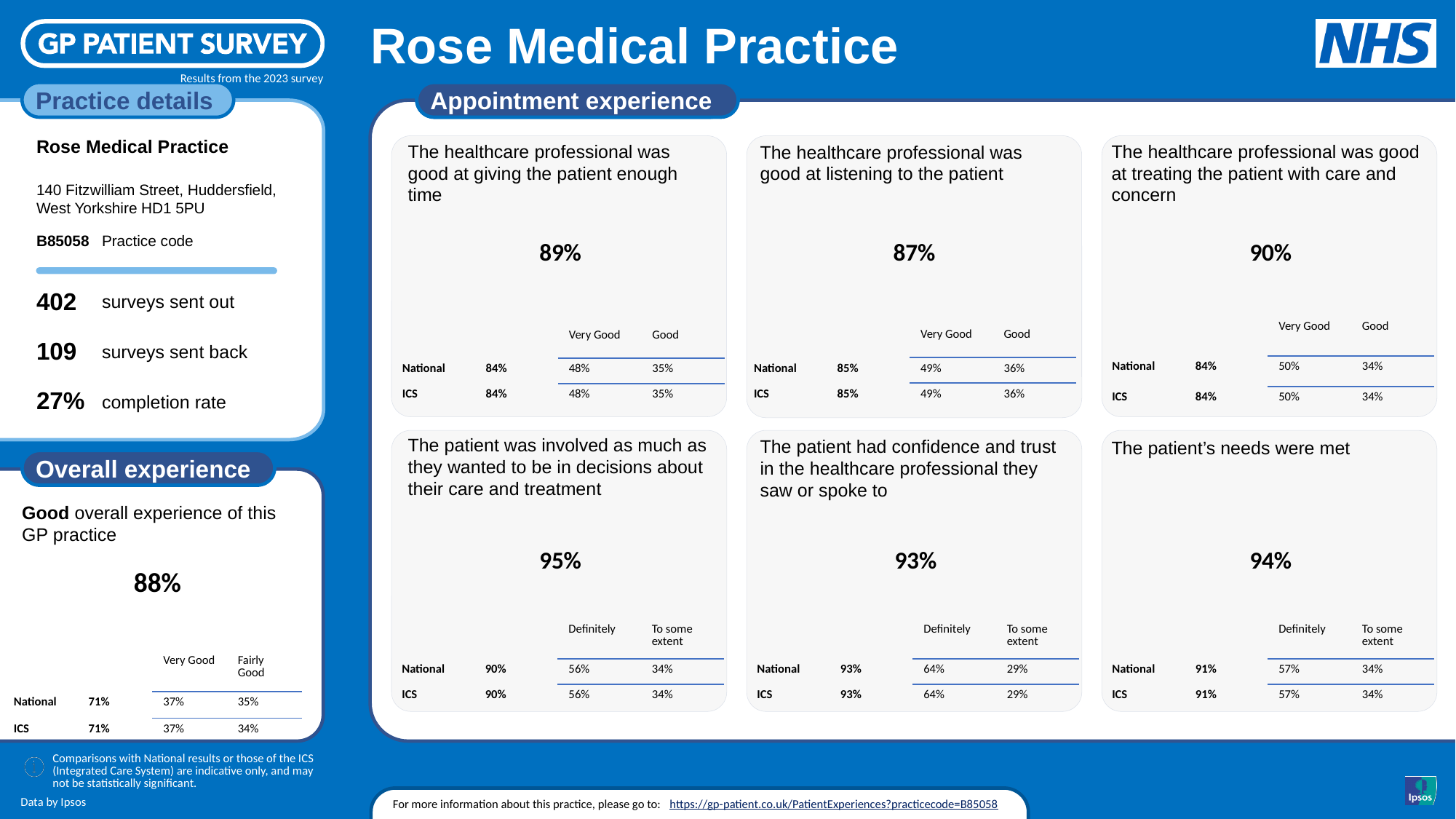
Among the six 'Appointment experience' panels, which question has the highest practice percentage? The patient was involved as much as they wanted to be in decisions about their care and treatment (95%) In the 'Overall experience' panel, what is the difference between the practice's 88% and the National 71%? 17 percentage points In the 'Overall experience' panel, what percentage of patients reported a good overall experience of this GP practice? 88% How many question panels are shown in the 'Appointment experience' section? 6 In the 'Overall experience' panel, what is the ICS 'Fairly Good' value? 34% In the panel 'The healthcare professional was good at treating the patient with care and concern', what is the ICS value? 84% In the panel 'The patient had confidence and trust in the healthcare professional they saw or spoke to', what is the National 'Definitely' value? 64% In the panel 'The healthcare professional was good at giving the patient enough time', what is the practice's headline percentage? 89% In the 'Overall experience' panel, what is the National value for good overall experience? 71% In the panel 'The healthcare professional was good at listening to the patient', what is the National 'Very Good' value? 49% In the panel 'The patient's needs were met', is the practice's 94% larger or smaller than the National 91%? larger Among the six 'Appointment experience' panels, which question has the lowest practice percentage? The healthcare professional was good at listening to the patient (87%)